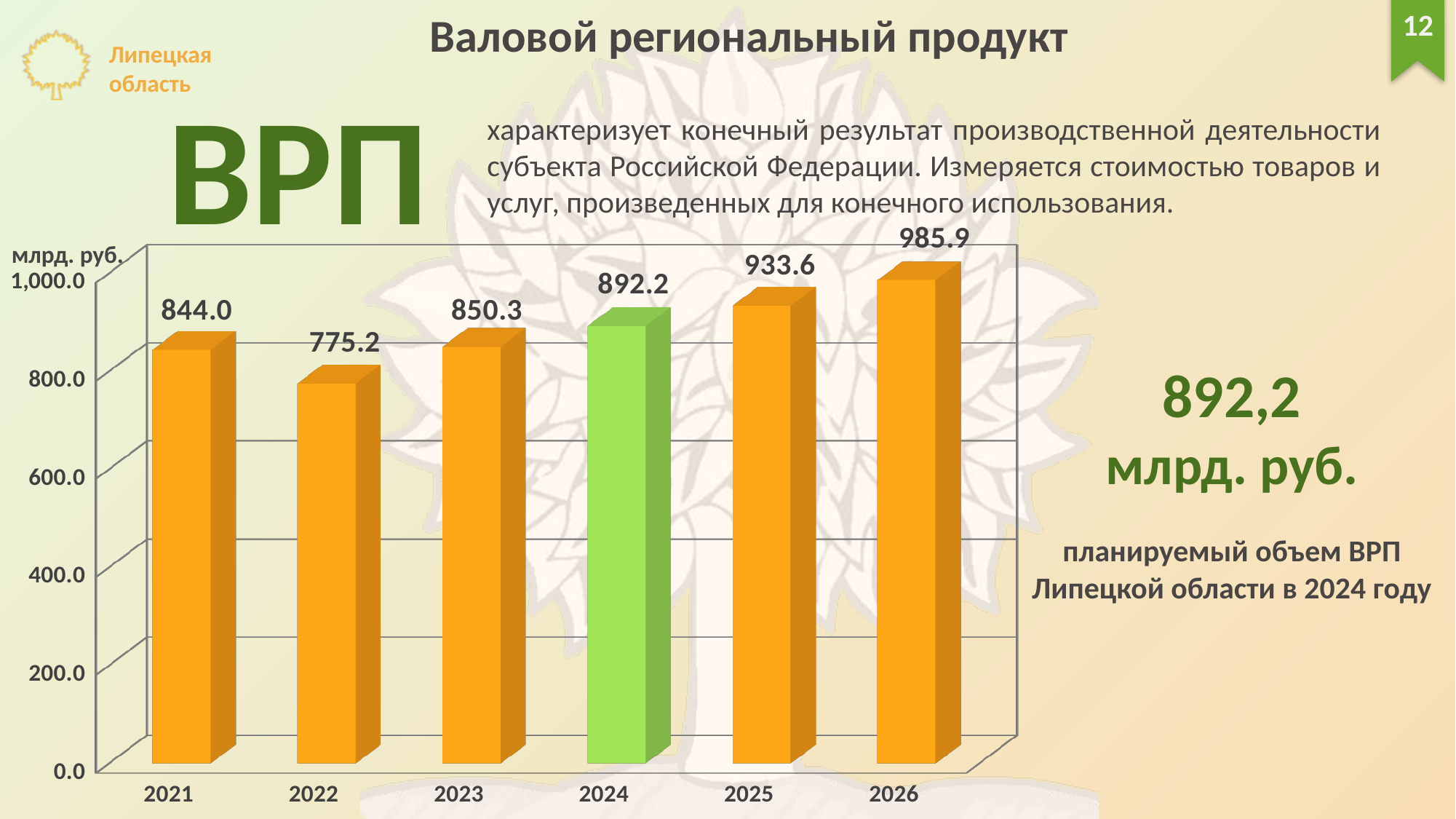
What is the difference between the values for 2026 and 2025? 52.3 What is the value for 2024? 892.2 What kind of chart is shown on the slide? bar chart Is the value for 2025 greater or less than 800.0? greater Which year has the highest value? 2026 Which year has the lowest value? 2022 Which is larger, the value for 2023 or the value for 2021? 2023 What is the difference between the values for 2021 and 2022? 68.8 Which bar is coloured green rather than orange? 2024 How many years are shown on the x axis? 6 What is the value for 2021? 844.0 What is the value for 2026? 985.9